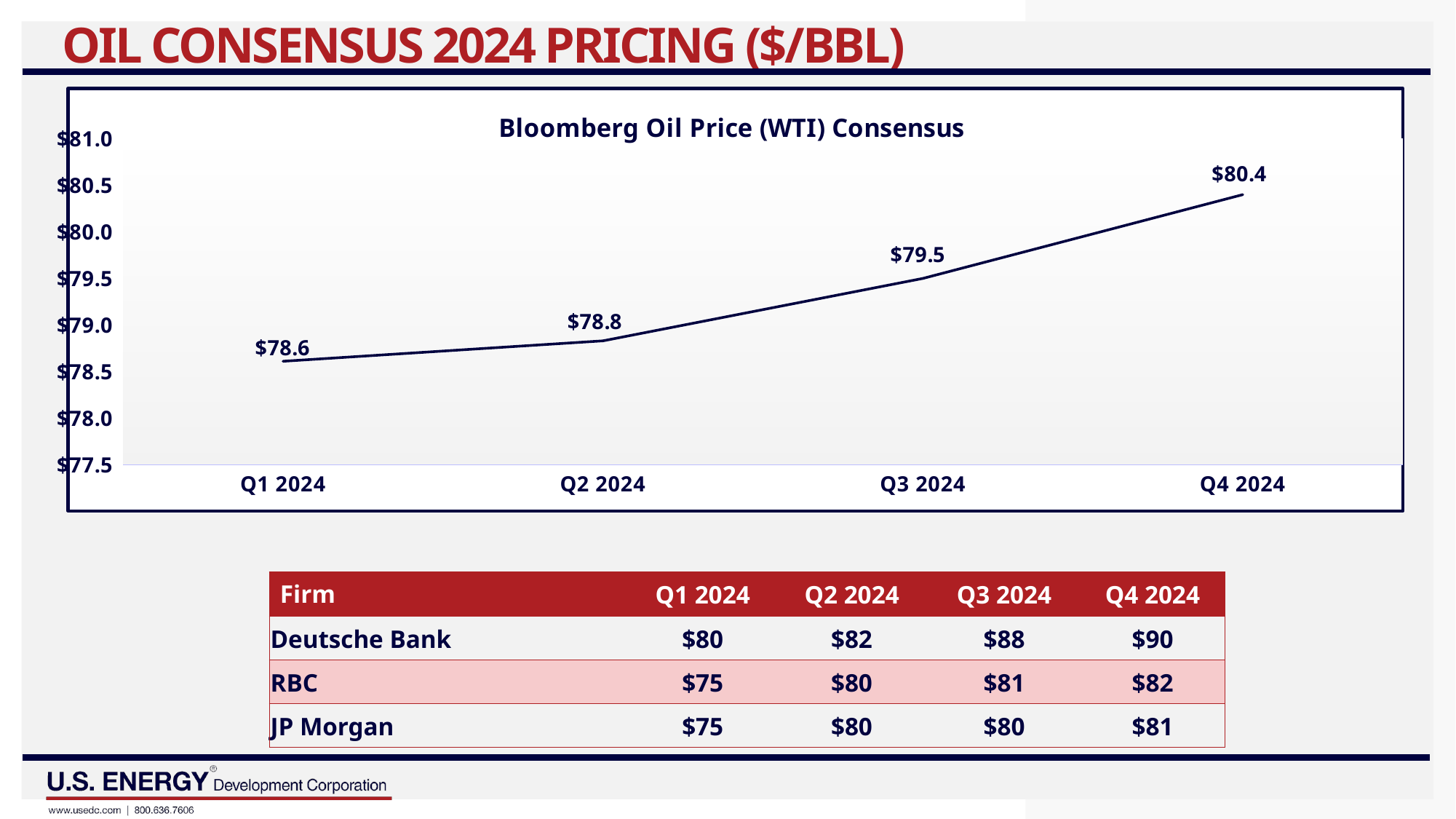
What is the difference between the Q3 2024 and Q2 2024 consensus values in the chart? $0.7 What is the Bloomberg Oil Price (WTI) Consensus value for Q4 2024? $80.4 What type of chart is shown on the slide? Line chart Which quarter has the highest Bloomberg Oil Price (WTI) Consensus value? Q4 2024 Which quarter has the lowest Bloomberg Oil Price (WTI) Consensus value? Q1 2024 Which is larger in the chart, the Q2 2024 value or the Q3 2024 value? Q3 2024 Is the Q4 2024 consensus value in the chart greater or less than $80.0? greater What is the Bloomberg Oil Price (WTI) Consensus value for Q3 2024? $79.5 What is the difference between the Q4 2024 and Q1 2024 consensus values in the chart? $1.8 What is the Bloomberg Oil Price (WTI) Consensus value for Q1 2024? $78.6 What is the Bloomberg Oil Price (WTI) Consensus value for Q2 2024? $78.8 How many quarters are plotted in the chart? 4